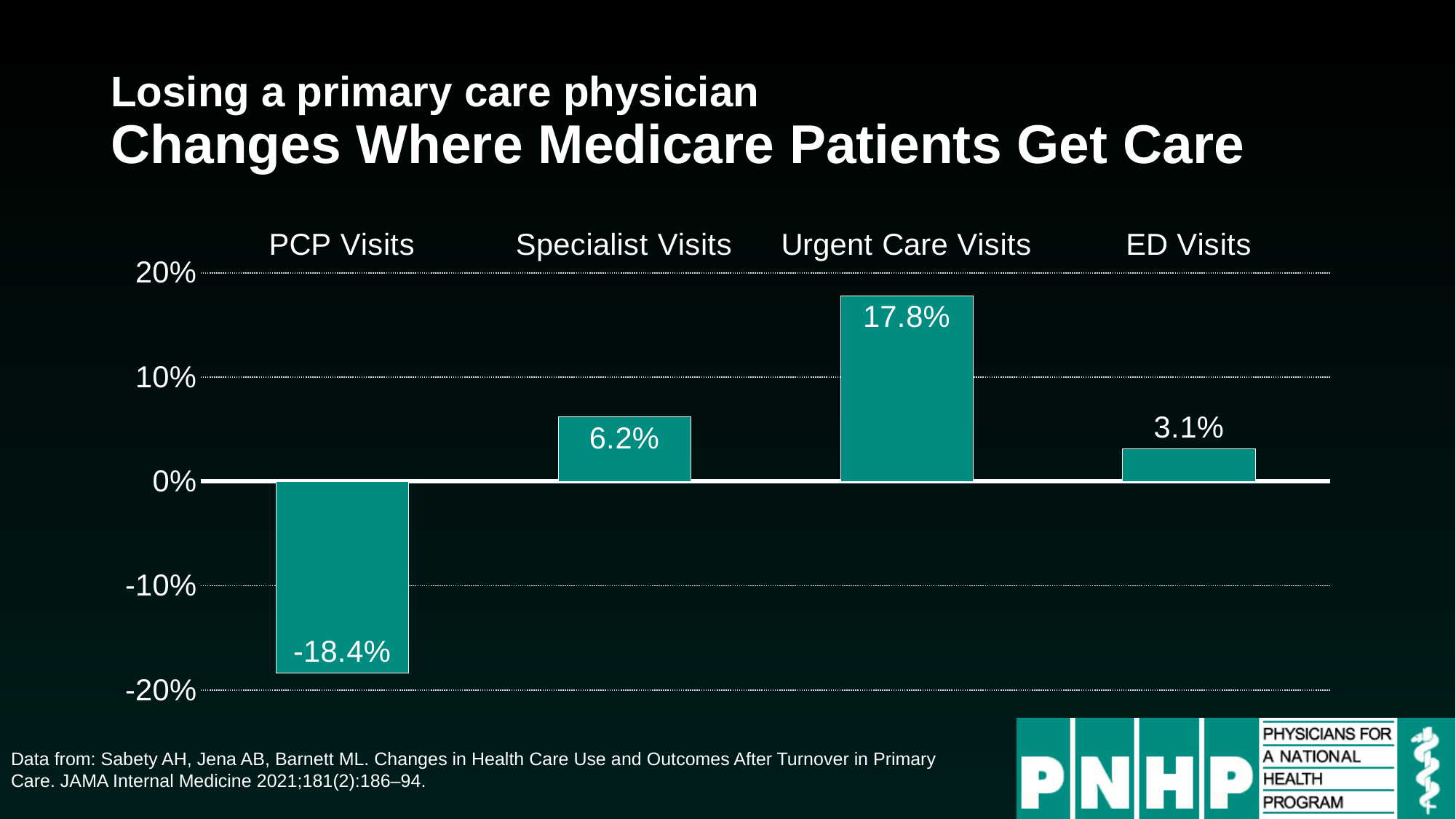
What is the value for Specialist Visits? 6.2% How many categories are shown in the chart? 4 What is the value for PCP Visits? -18.4% Is the value for Urgent Care Visits greater or less than 10%? greater What is the value for ED Visits? 3.1% Which category has the lowest value? PCP Visits What is the value for Urgent Care Visits? 17.8% Which category has the highest value? Urgent Care Visits Which is larger, the value for Specialist Visits or the value for ED Visits? Specialist Visits What is the difference between the values for Urgent Care Visits and Specialist Visits? 11.6% What kind of chart is shown on the slide? bar chart How many categories have a negative value? 1